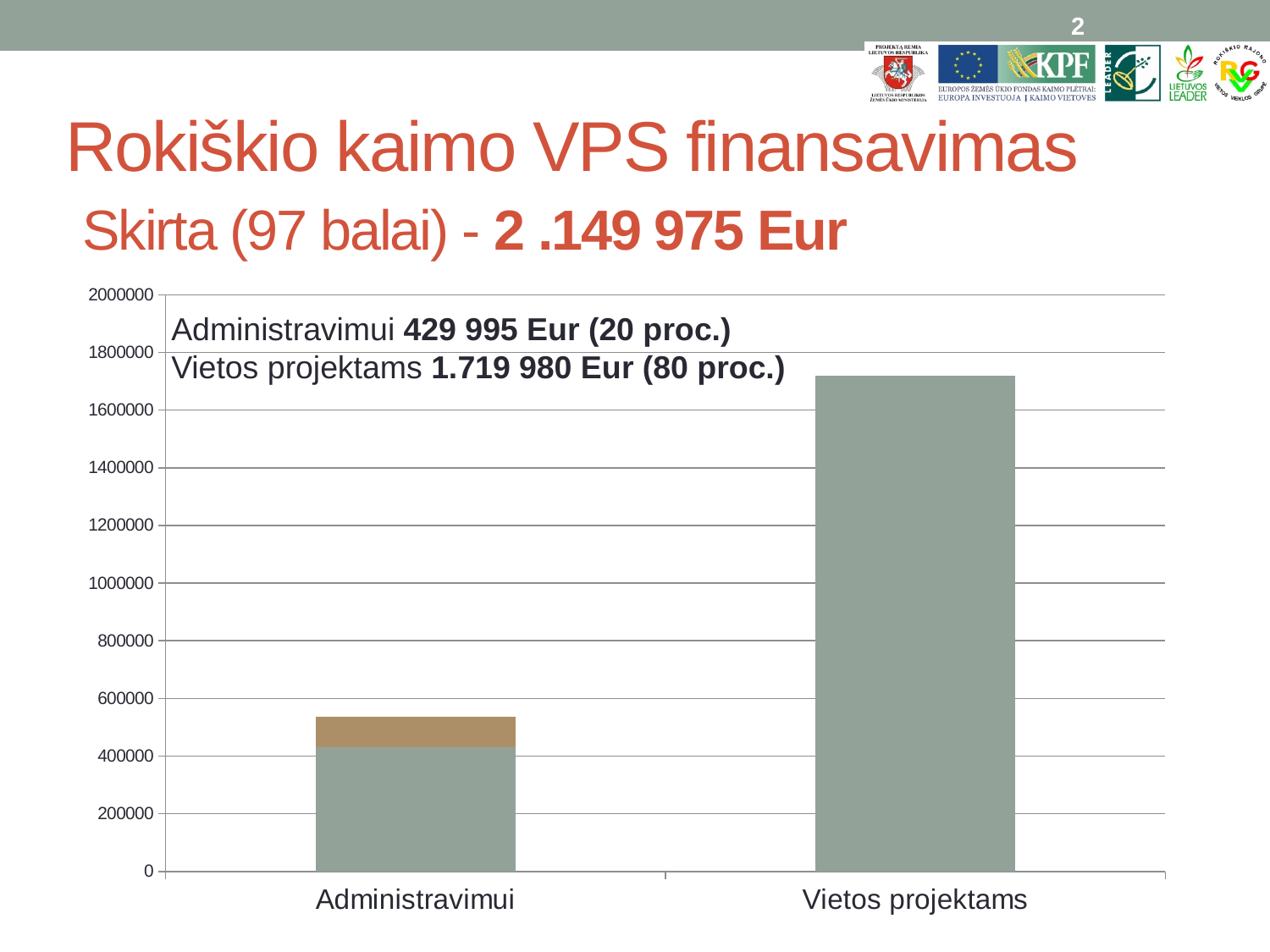
Which category has the highest bar in the chart? Vietos projektams What percentage of the funding goes to Vietos projektams, according to the text on the chart? 80 proc. According to the text printed on the chart, how much is allocated to Vietos projektams? 1.719 980 Eur Is the value of the Vietos projektams bar greater or less than 1600000? greater What is the highest value labelled on the vertical axis of the chart? 2000000 Which bar is taller, Administravimui or Vietos projektams? Vietos projektams What percentage of the funding goes to Administravimui, according to the text on the chart? 20 proc. What kind of chart is shown on the slide? bar chart How many categories are shown on the x axis of the chart? 2 According to the text printed on the chart, how much is allocated to Administravimui? 429 995 Eur Is the value of the Administravimui bar greater or less than 800000? less Which category has the lowest bar in the chart? Administravimui